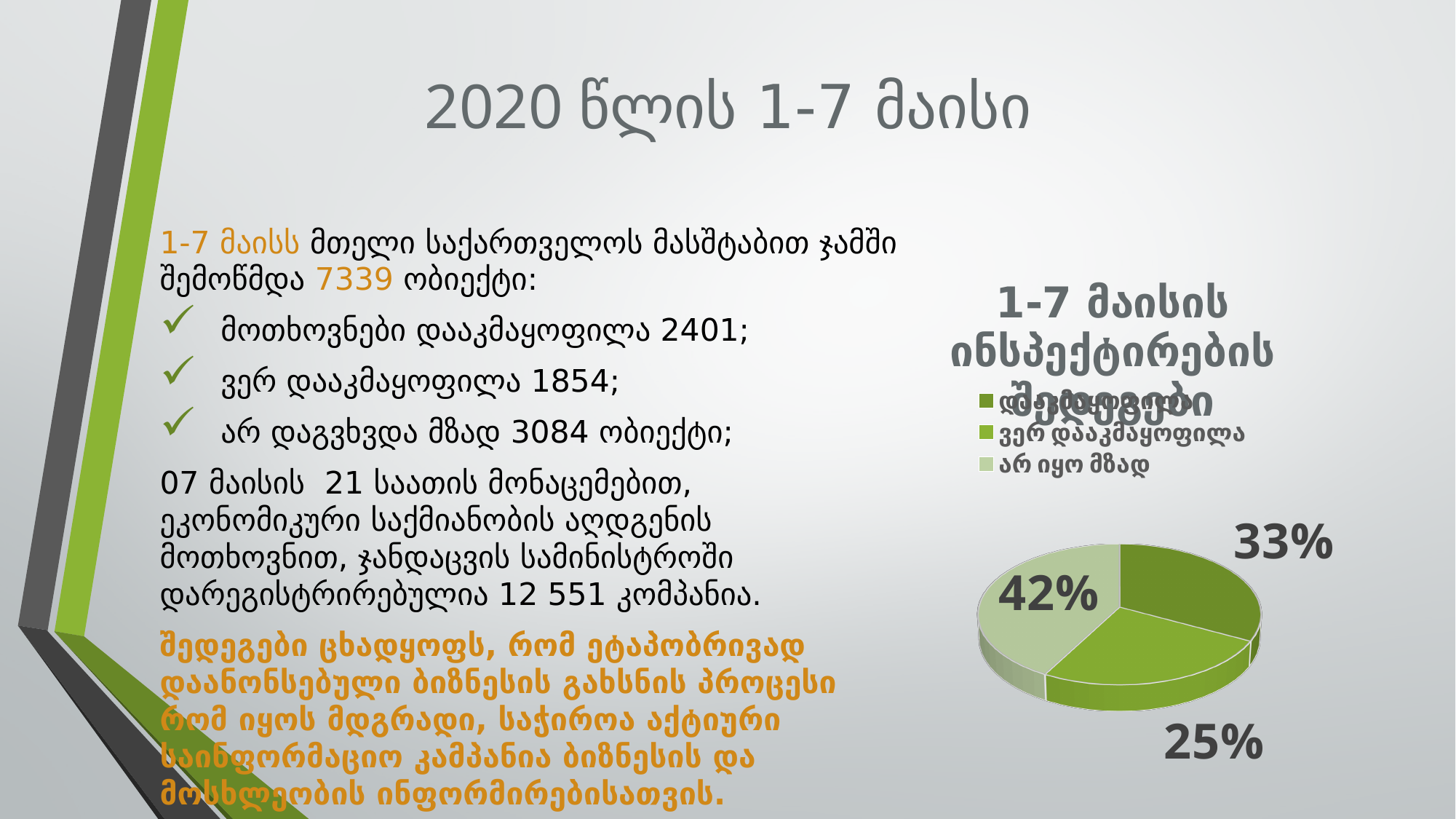
What colour is the largest slice of the pie chart? Light green How many slices does the pie chart have? 3 What is the title of the pie chart? 1-7 მაისის ინსპექტირების შედეგები What percentage does the pie chart show for "ვერ დააკმაყოფილა"? 25% Which category has the largest slice in the pie chart? არ იყო მზად What kind of chart is shown on the slide? Pie chart Which slice is larger in the pie chart: "ვერ დააკმაყოფილა" or "არ იყო მზად"? არ იყო მზად Which category has the smallest slice in the pie chart? ვერ დააკმაყოფილა What percentage is shown on the dark green slice of the pie chart? 33% What is the difference in percentage points between the "არ იყო მზად" slice and the "ვერ დააკმაყოფილა" slice? 17% How many entries does the legend of the pie chart list? 3 What percentage does the pie chart show for "არ იყო მზად"? 42%